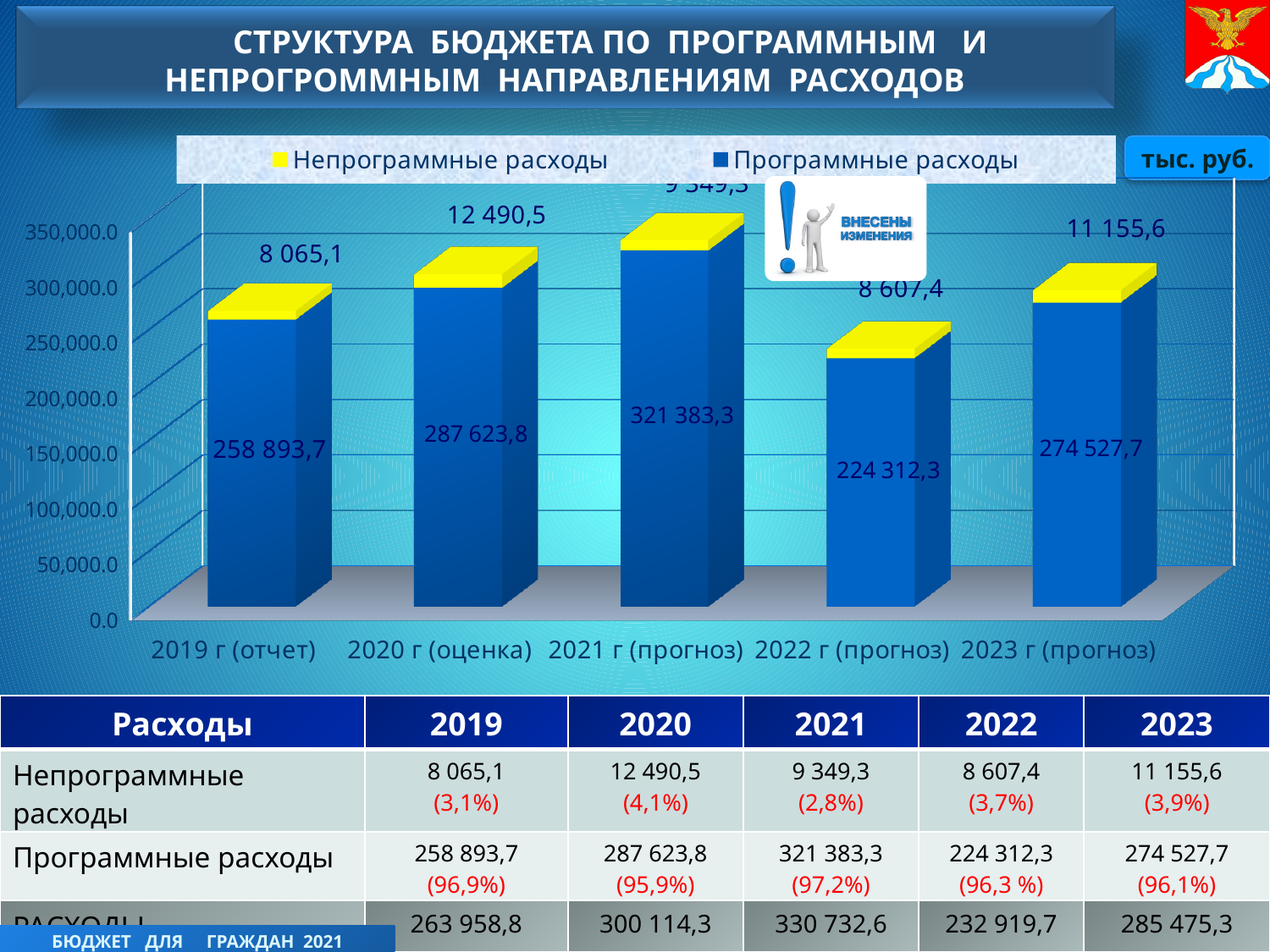
How many years (categories) are shown on the x axis of the chart? 5 What is the difference between Программные расходы in 2021 г (прогноз) and 2020 г (оценка)? 33 759,5 Is the value of Программные расходы for 2022 г (прогноз) greater or less than 250,000.0? less In which year are Программные расходы the lowest? 2022 г (прогноз) Which is larger: Непрограммные расходы in 2023 г (прогноз) or in 2019 г (отчет)? 2023 г (прогноз) What is the total of the stacked bar for 2022 г (прогноз)? 232 919,7 In which year are Программные расходы the highest? 2021 г (прогноз) What is the value of Программные расходы for 2019 г (отчет)? 258 893,7 What kind of chart is shown on the slide? bar chart What is the value of Непрограммные расходы for 2020 г (оценка)? 12 490,5 How many series does the chart legend list? 2 What is the value of Программные расходы for 2023 г (прогноз)? 274 527,7